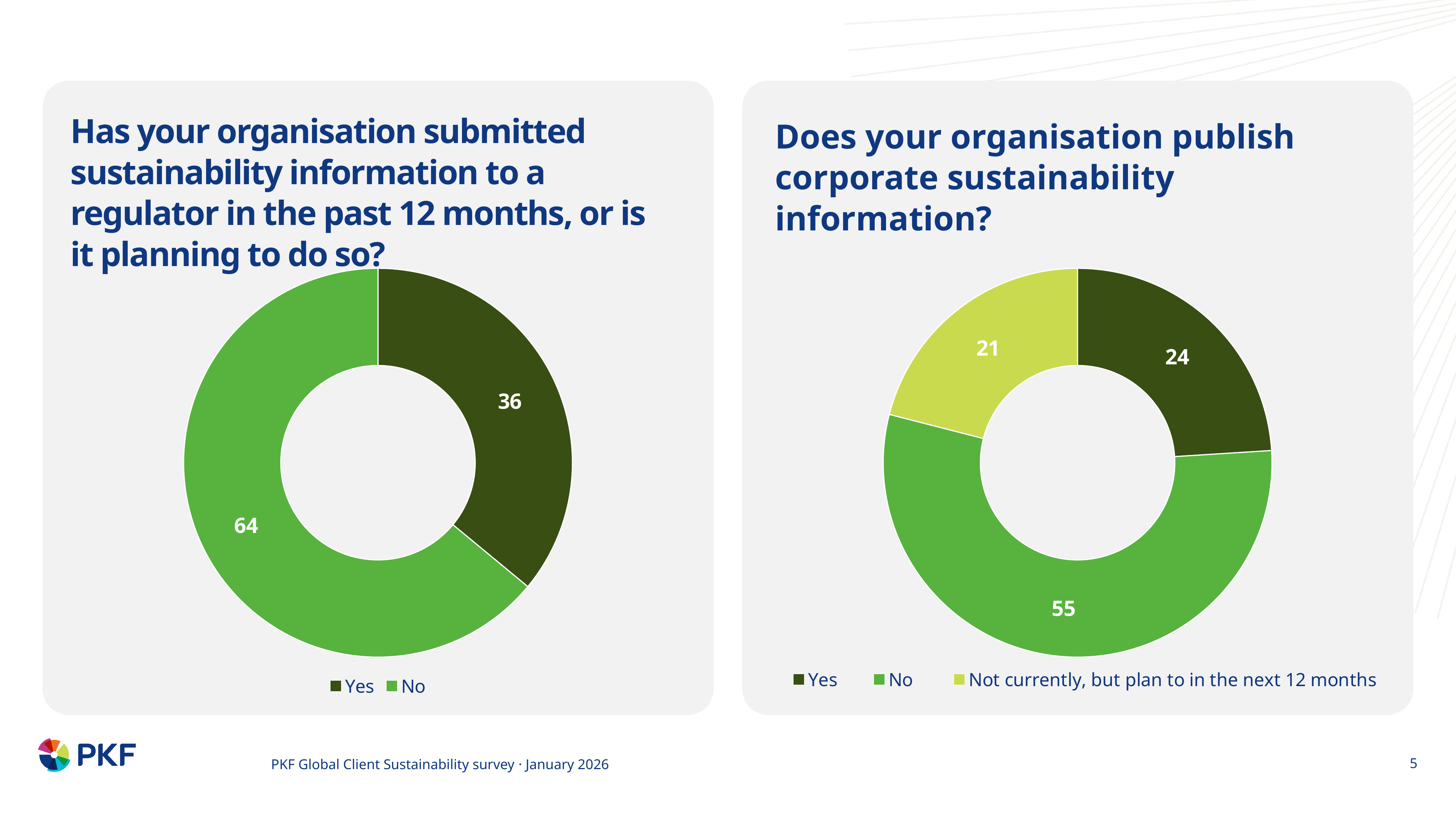
In the left chart (submitted sustainability information to a regulator), what is the value for No? 64 In the right chart (publish corporate sustainability information), which category has the smallest slice? Not currently, but plan to in the next 12 months What kind of chart is the left chart (submitted sustainability information to a regulator)? Doughnut chart In the right chart (publish corporate sustainability information), how many categories are shown? 3 In the left chart (submitted sustainability information to a regulator), what is the difference between the No and Yes values? 28 In the right chart (publish corporate sustainability information), what colour is the No slice? Green In the left chart (submitted sustainability information to a regulator), how many categories does the legend list? 2 In the right chart (publish corporate sustainability information), what is the value for 'Not currently, but plan to in the next 12 months'? 21 In the left chart (submitted sustainability information to a regulator), which category has the largest slice? No In the right chart (publish corporate sustainability information), which is larger, Yes or No? No In the right chart (publish corporate sustainability information), what is the value for Yes? 24 In the left chart (submitted sustainability information to a regulator), what is the value for Yes? 36